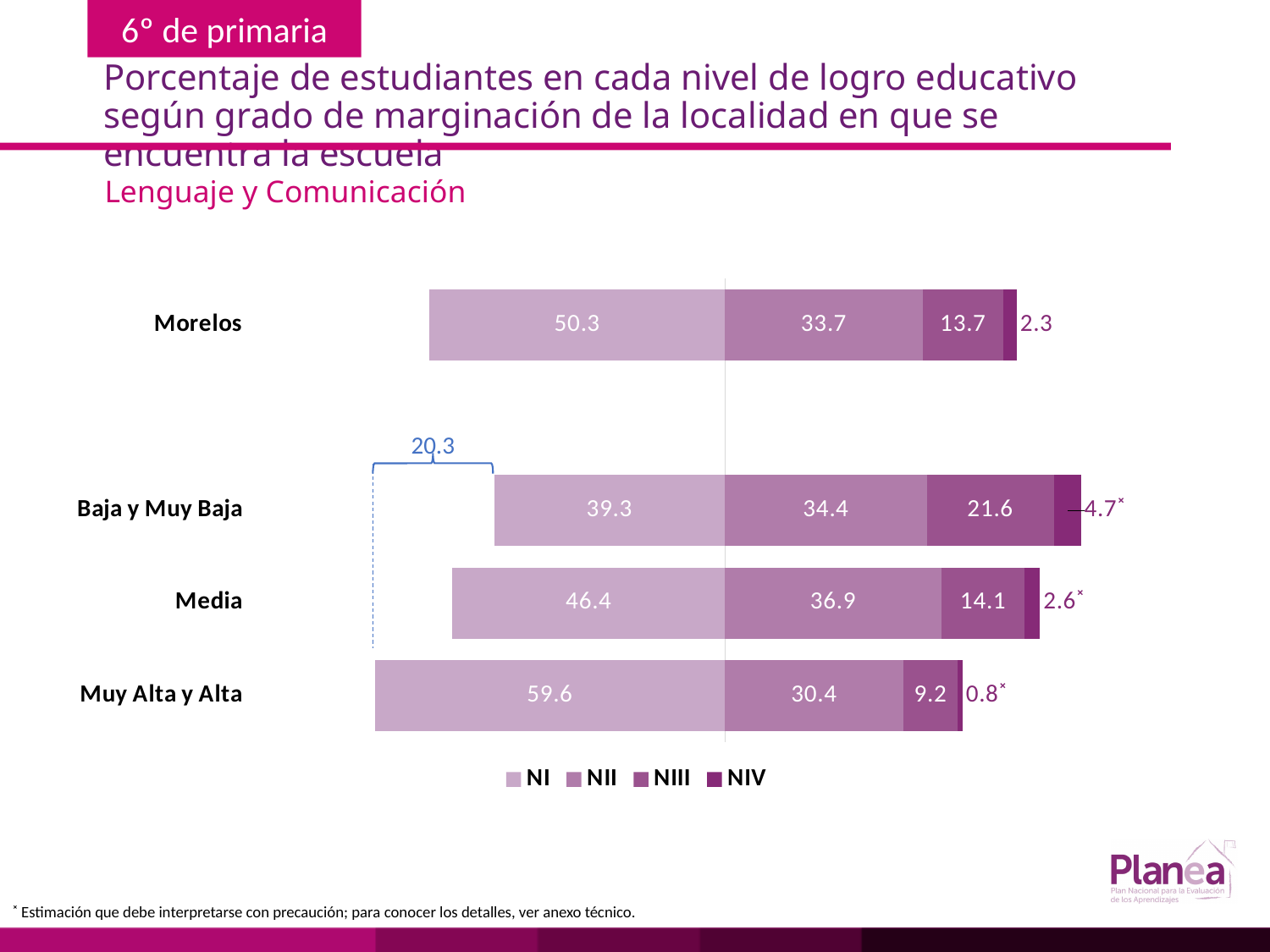
Which is larger, the NII value for Morelos or the NII value for Baja y Muy Baja? Baja y Muy Baja What is the NIII value for Baja y Muy Baja? 21.6 Which category has the highest NI value? Muy Alta y Alta What is the total of the stacked bar for Media? 100.0 What is the difference between the NI values for Muy Alta y Alta and Baja y Muy Baja? 20.3 How many series does the legend list? 4 What is the NI value for Morelos? 50.3 Which category has the lowest NIII value? Muy Alta y Alta What is the NII value for Media? 36.9 What is the NIV value for Muy Alta y Alta? 0.8 How many categories are shown on the chart? 4 What type of chart is shown on the slide? Stacked bar chart